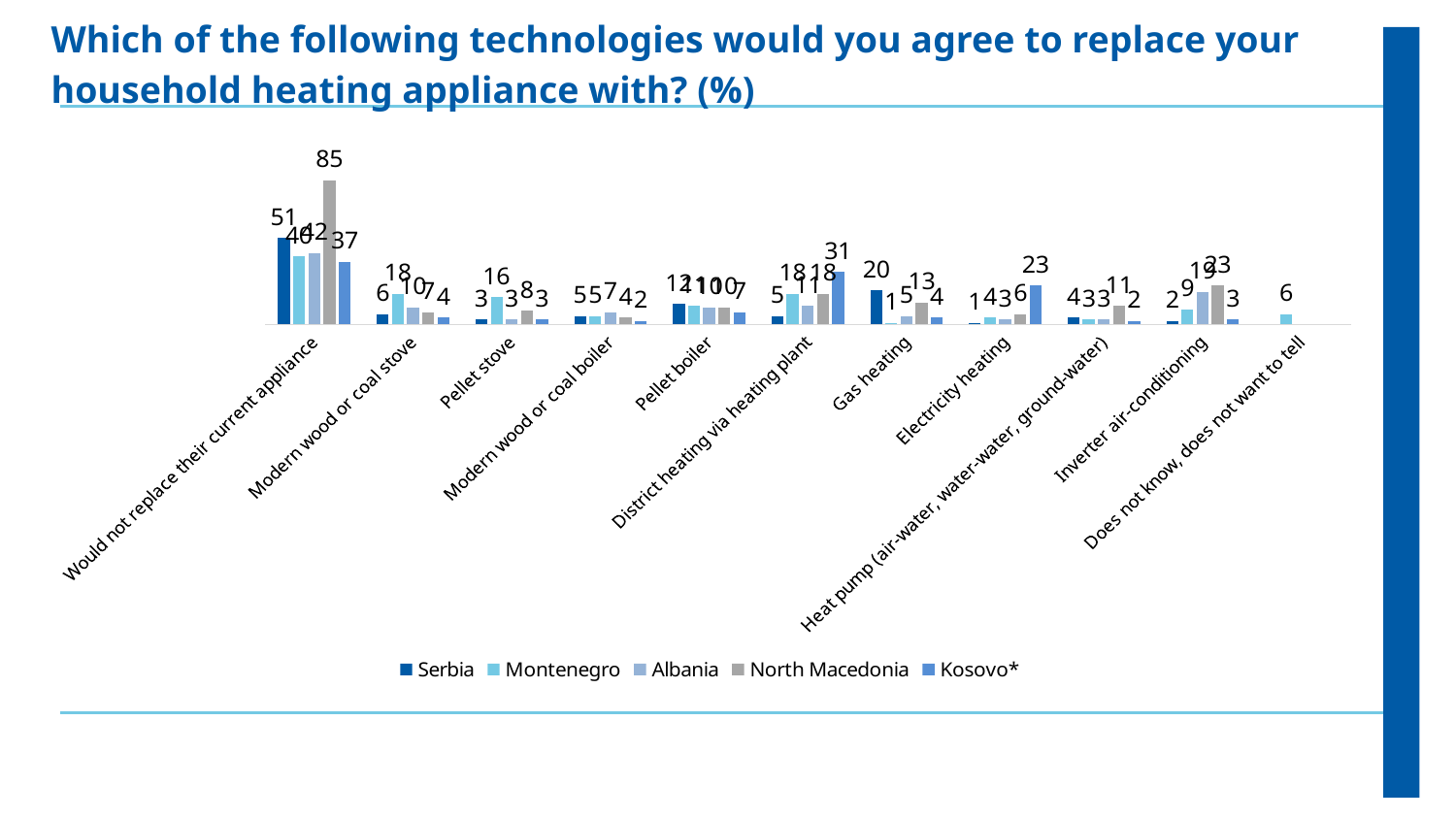
What is the value for Montenegro in the 'Does not know, does not want to tell' category? 6 Which country has the highest value in the 'Pellet stove' category? Montenegro What is the value for Kosovo* in the 'District heating via heating plant' category? 31 What is the difference between North Macedonia and Serbia in the 'Would not replace their current appliance' category? 34 What is the value for Kosovo* in the 'Electricity heating' category? 23 Which is larger: Serbia's value for 'Gas heating' or Montenegro's value for 'Modern wood or coal stove'? Serbia's value for Gas heating What is the value for North Macedonia in the 'Would not replace their current appliance' category? 85 What is the value for Serbia in the 'Would not replace their current appliance' category? 51 How many series does the legend list? 5 Which country has the highest value in the 'Would not replace their current appliance' category? North Macedonia What type of chart is shown on the slide? bar chart What is the value for Serbia in the 'Gas heating' category? 20